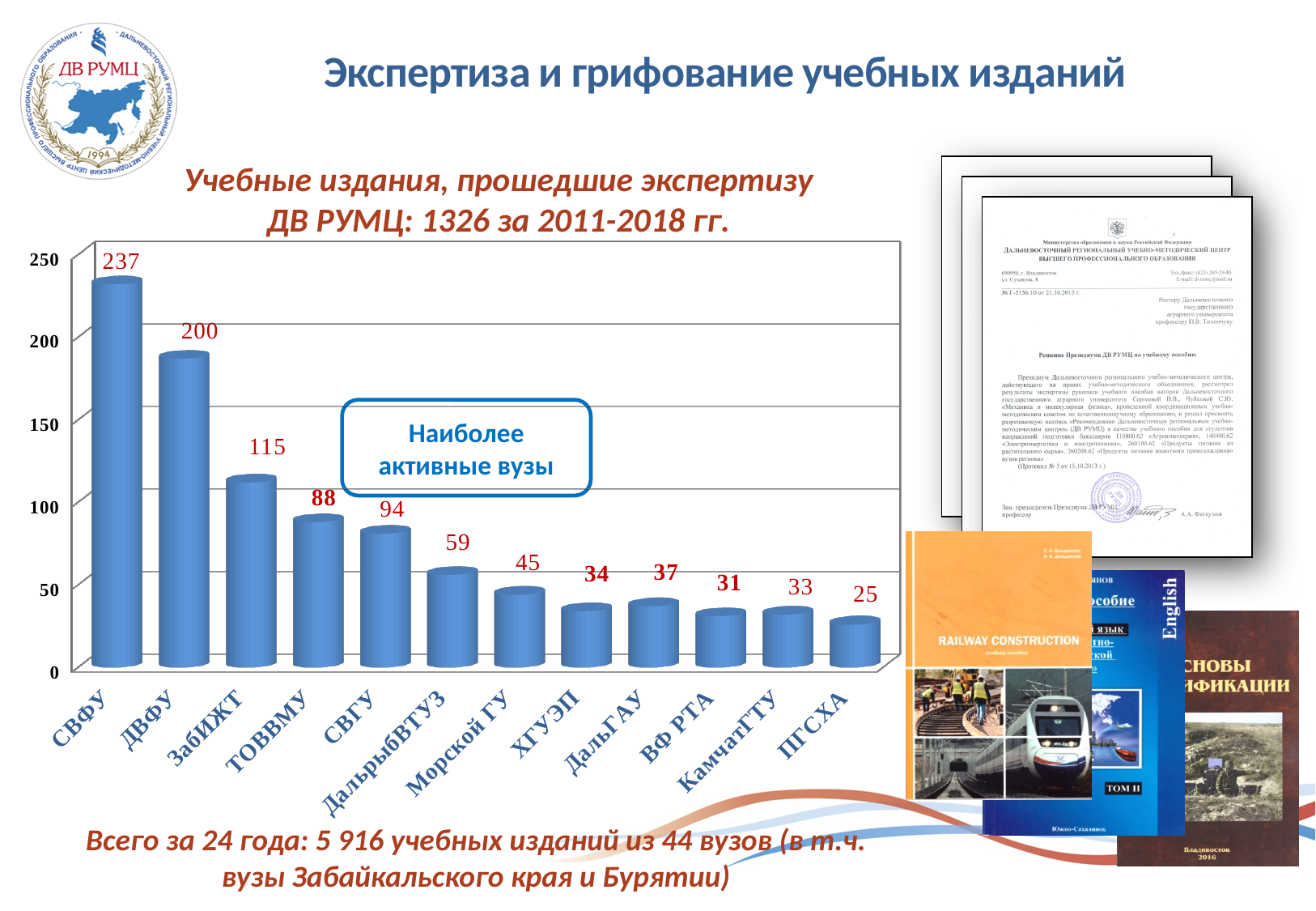
What is the value for ДВФУ? 200 What total number of publications does the chart title state for 2011-2018? 1326 Is the value for Морской ГУ greater or less than 50? less What kind of chart is shown on the slide? bar chart What is the value for СВФУ? 237 What is the value for ДальрыбВТУЗ? 59 How many universities are shown on the chart? 12 What is the difference between the values for СВФУ and ДВФУ? 37 What is the value for ЗабИЖТ? 115 Which university has the highest value? СВФУ Which is larger, the value for ТОВВМУ or the value for СВГУ? СВГУ Which university has the lowest value? ПГСХА